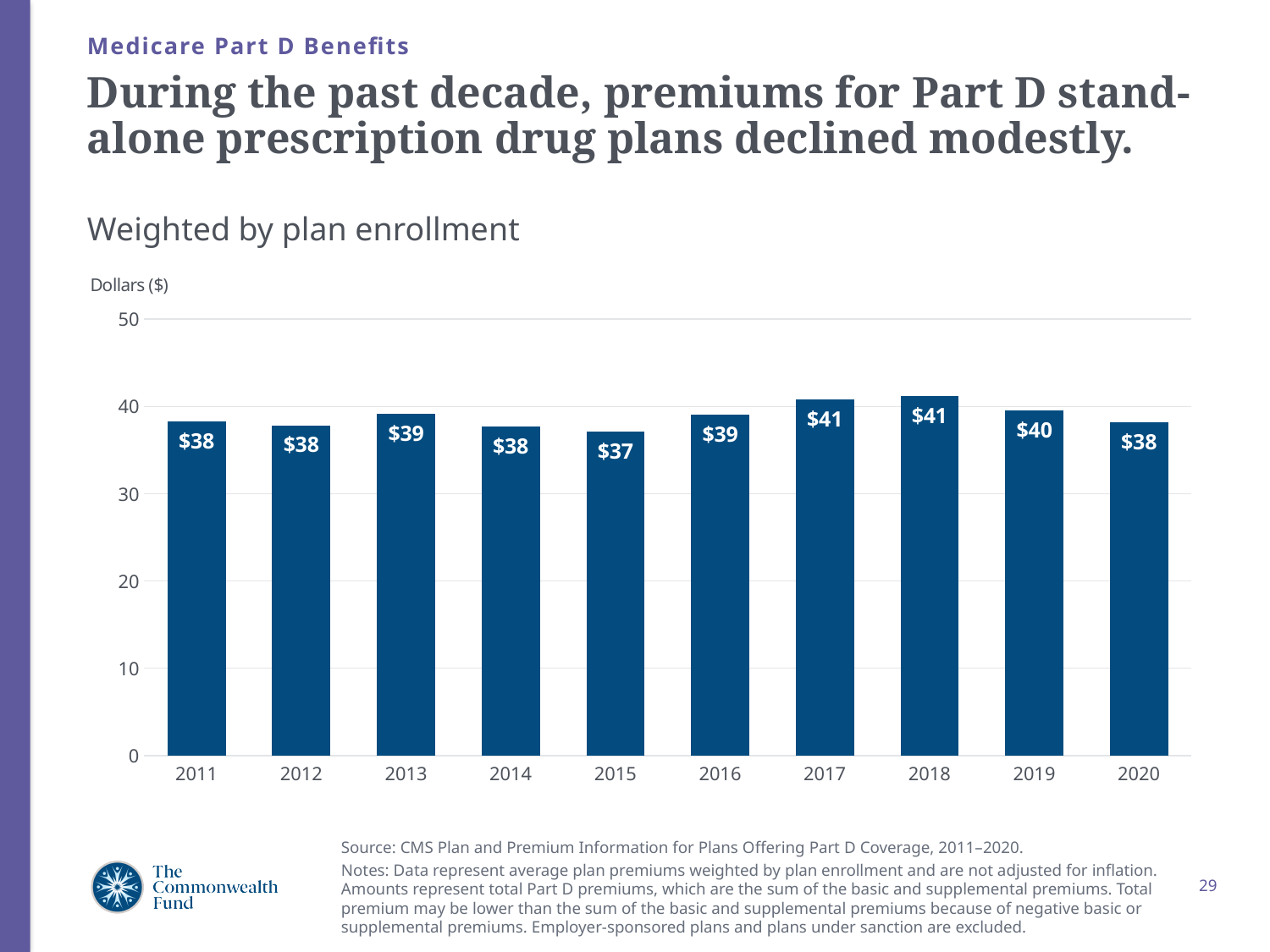
Is the value for 2015 greater or less than 40? less What was the weighted average Part D premium in 2015? $37 What was the weighted average Part D premium in 2019? $40 Is the value for 2018 greater or less than 40? greater What kind of chart is shown on the slide? Bar chart What was the weighted average Part D premium in 2020? $38 What unit is shown on the y axis label of the chart? Dollars ($) What is the difference between the premium in 2018 and the premium in 2015? $4 Which year had a higher premium, 2017 or 2019? 2017 Which year had the lowest weighted average Part D premium? 2015 How many years are shown on the x axis of the chart? 10 What is the difference between the premium in 2011 and the premium in 2017? $3